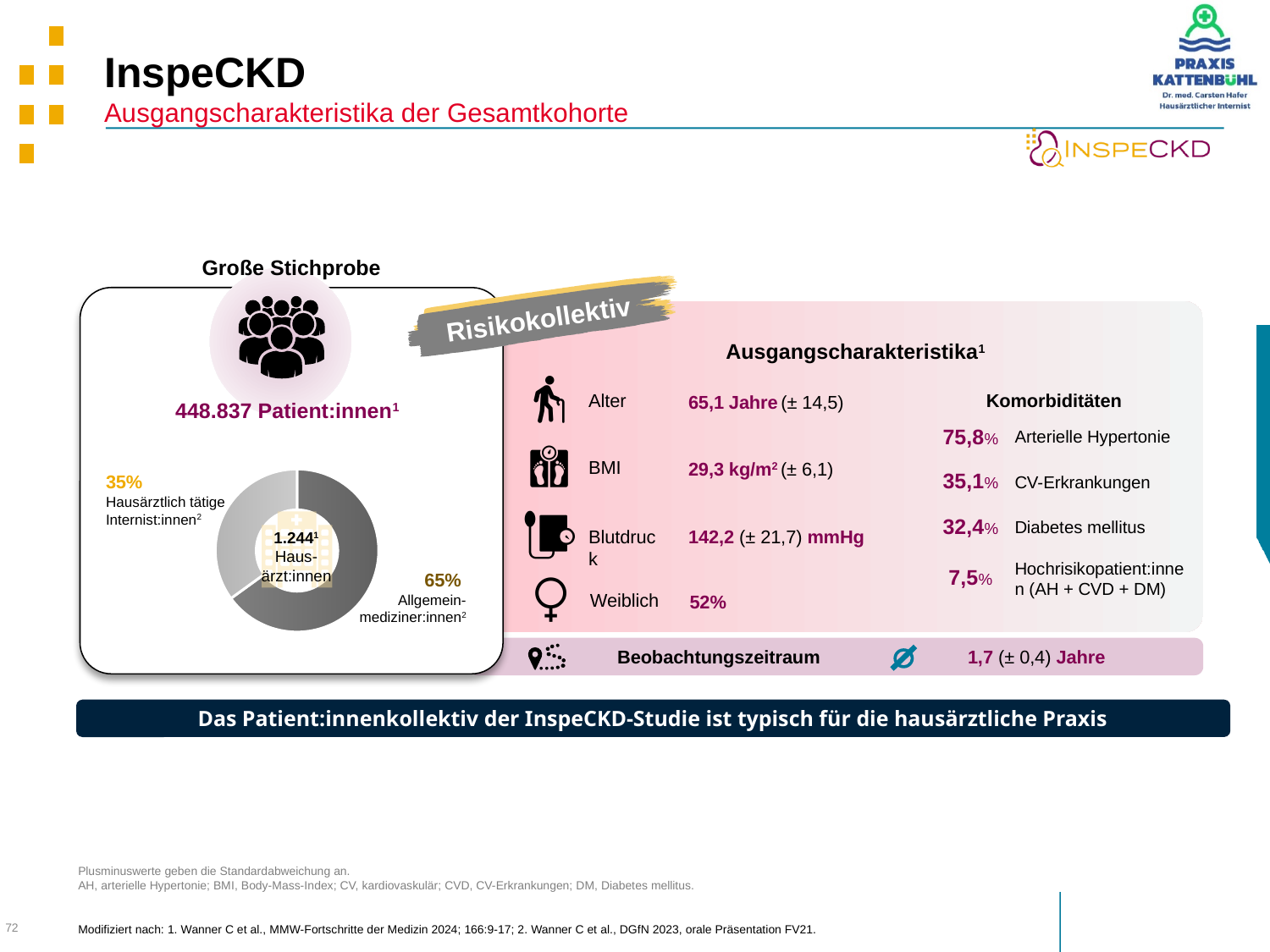
Which category has the smallest share in the donut chart? Hausärztlich tätige Internist:innen In the donut chart, what share is labelled for Hausärztlich tätige Internist:innen? 35% In the donut chart, what share is labelled for Allgemeinmediziner:innen? 65% What kind of chart is shown on the left of the slide? Donut (pie) chart How many segments does the donut chart have? 2 What is the difference in percentage points between the two segments of the donut chart? 30 percentage points Which segment of the donut chart is larger: Allgemeinmediziner:innen or Hausärztlich tätige Internist:innen? Allgemeinmediziner:innen Which category has the largest share in the donut chart? Allgemeinmediziner:innen What is the heading above the box containing the donut chart? Große Stichprobe What number is shown in the centre of the donut chart? 1.244 Hausärzt:innen